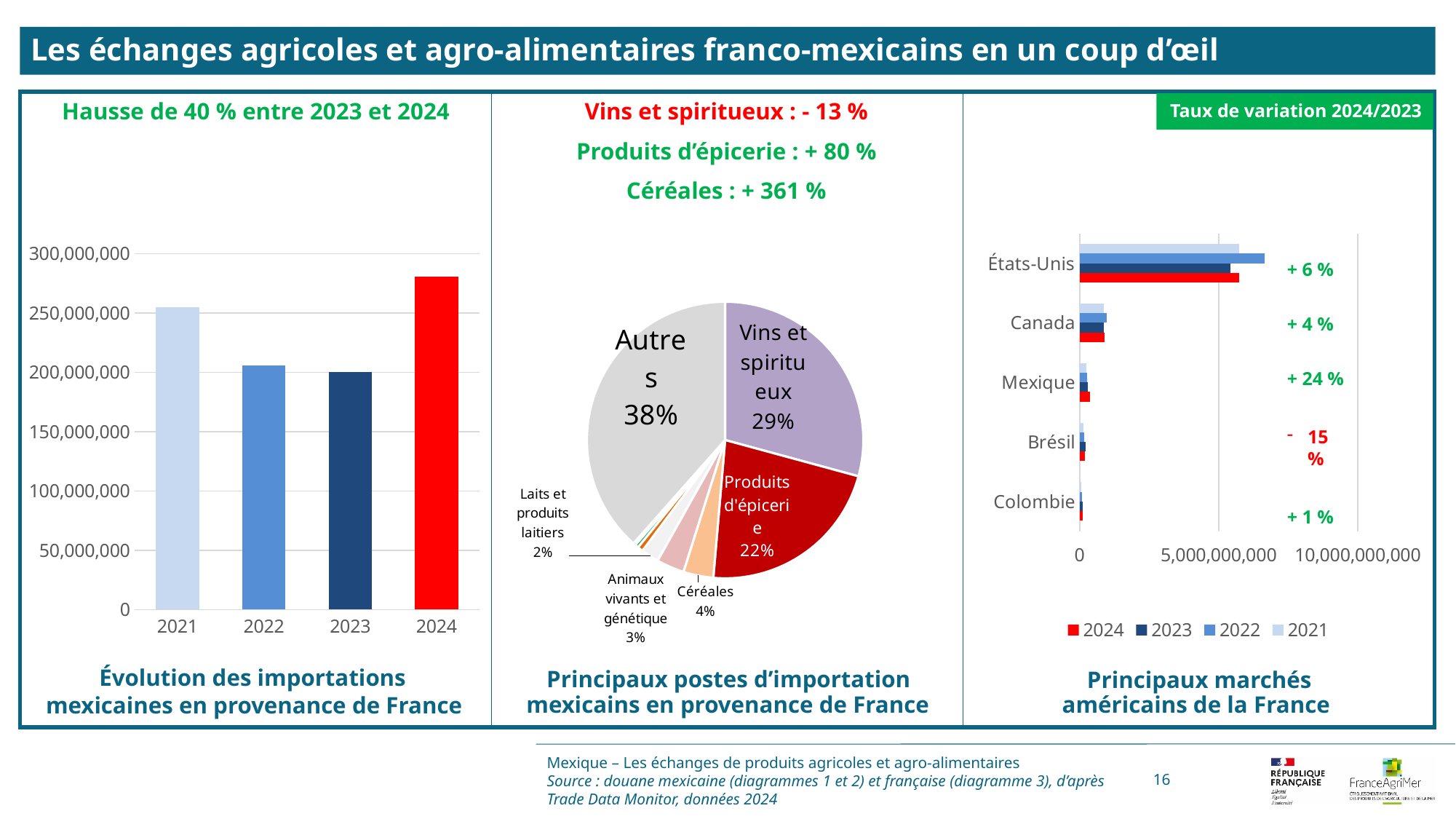
On the chart 'Évolution des importations mexicaines en provenance de France', is the value for 2021 greater or less than 250,000,000? greater On the chart 'Évolution des importations mexicaines en provenance de France', how many years are shown on the x axis? 4 On the chart 'Principaux marchés américains de la France', is the 2022 value for États-Unis greater or less than 5,000,000,000? greater On the chart 'Évolution des importations mexicaines en provenance de France', which is larger, the value for 2022 or the value for 2024? 2024 On the chart 'Évolution des importations mexicaines en provenance de France', which year has the highest value? 2024 On the chart 'Évolution des importations mexicaines en provenance de France', is the value for 2023 greater or less than 250,000,000? less What kind of chart is 'Évolution des importations mexicaines en provenance de France'? bar chart On the pie chart 'Principaux postes d'importation mexicains en provenance de France', what share does 'Céréales' have? 4% On the pie chart 'Principaux postes d'importation mexicains en provenance de France', which labelled slice is the largest? Autres On the pie chart 'Principaux postes d'importation mexicains en provenance de France', what share does 'Vins et spiritueux' have? 29% On the chart 'Principaux marchés américains de la France', which country has the highest values? États-Unis On the chart 'Principaux marchés américains de la France', how many series does the legend list? 4